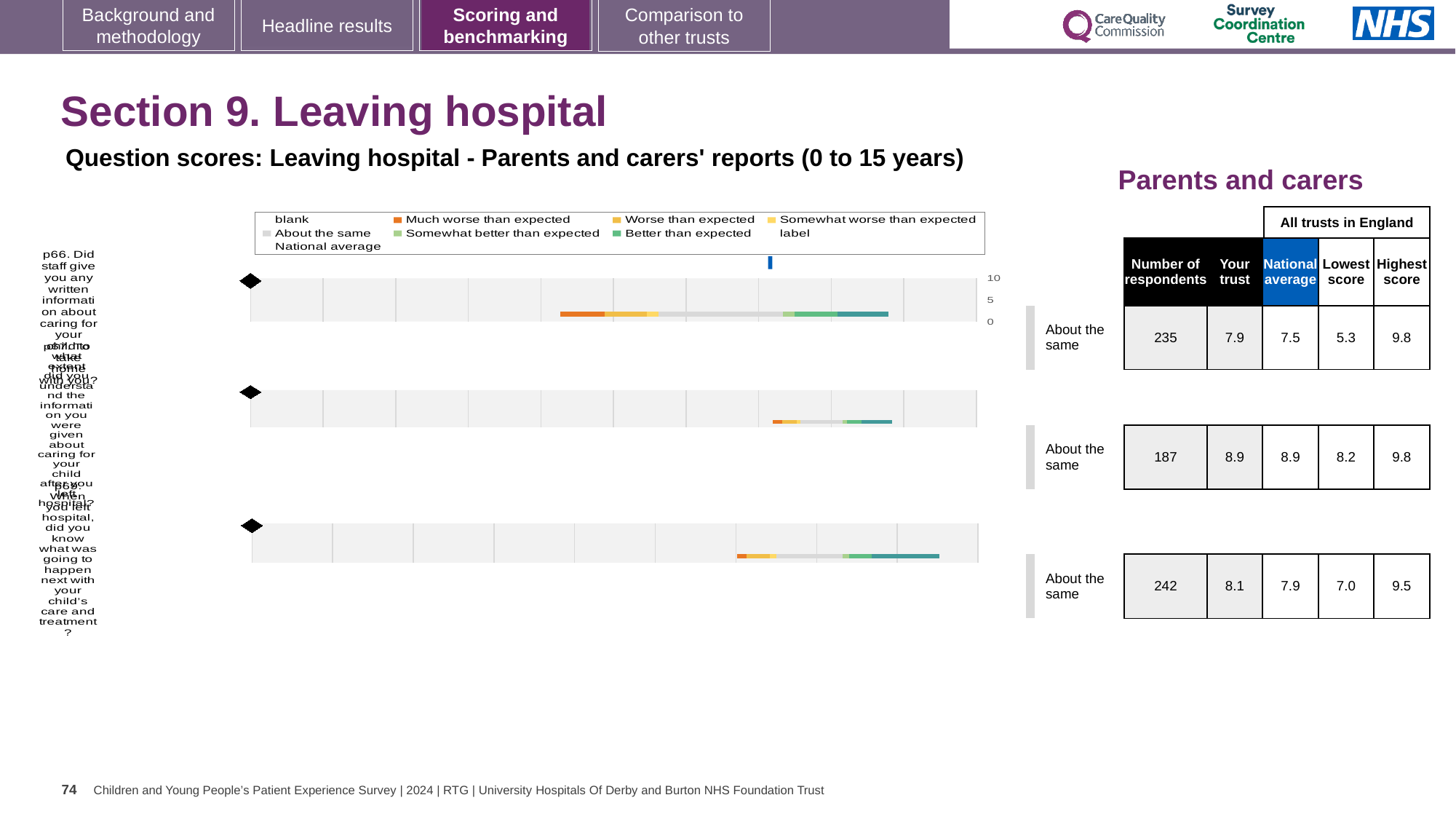
For the middle chart, what is the 'Your trust' score shown in the table? 8.9 For the top chart, what is the 'Your trust' score shown in the table? 7.9 For the top chart, how many respondents are shown in the table? 235 For the bottom chart, what is the lowest score across all trusts in England? 7.0 For the top chart, what is the difference between the 'Your trust' score and the national average? 0.4 For the bottom chart, which is larger: the 'Your trust' score or the national average? Your trust Which of the three charts (top, middle or bottom) has the highest 'Your trust' score? middle For the bottom chart, what is the highest score across all trusts in England? 9.5 Which of the three charts (top, middle or bottom) has the largest number of respondents? bottom What benchmark category is shown next to each of the three charts? About the same For the top chart, what is the national average score shown in the table? 7.5 What kind of chart is used to show the question scores on this slide? bar chart